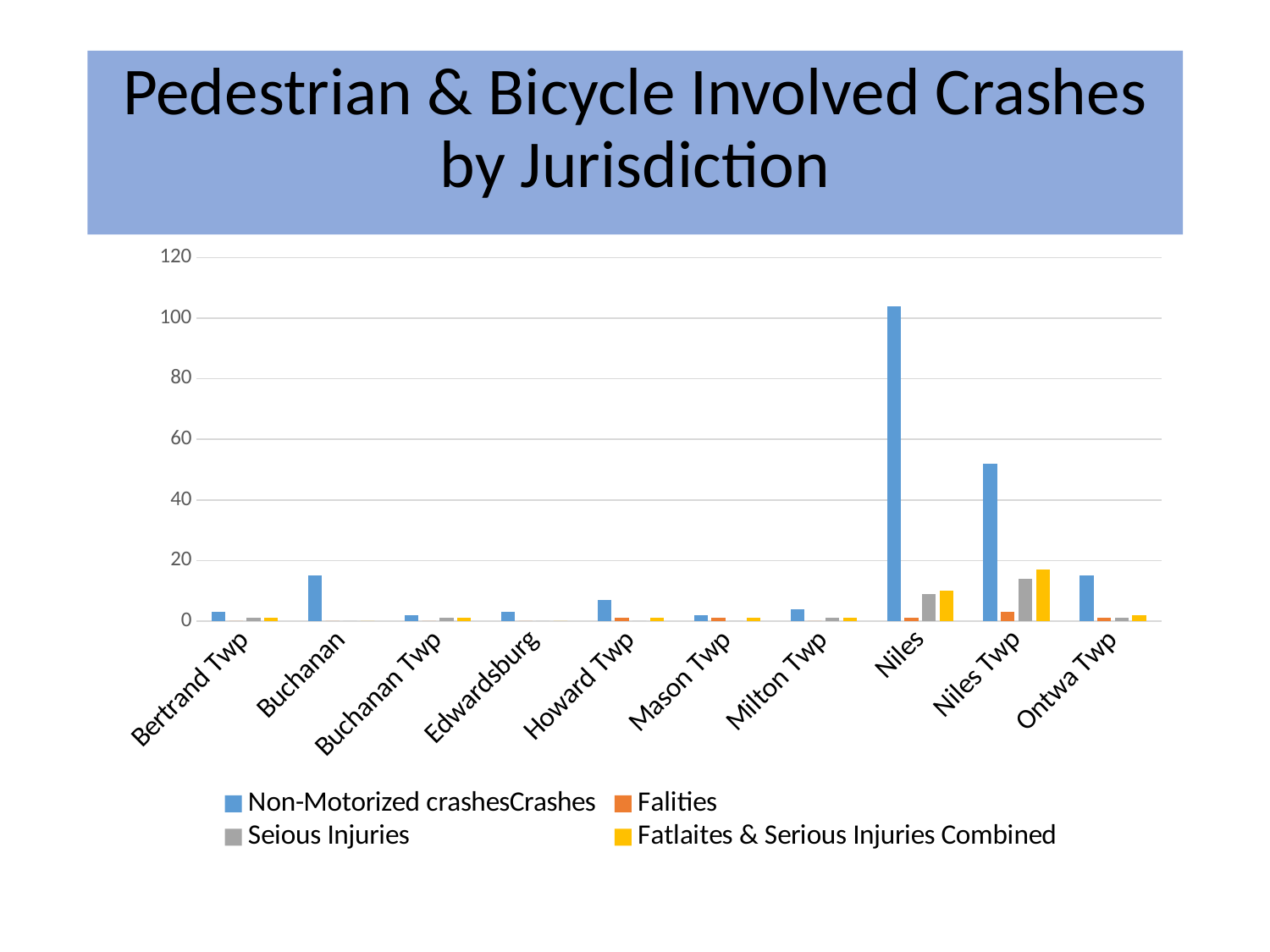
Is the Non-Motorized crashes value for Buchanan greater or less than 20? less Which has more Non-Motorized crashes, Niles or Niles Twp? Niles How many jurisdictions are shown on the x axis? 10 What is the title of the slide? Pedestrian & Bicycle Involved Crashes by Jurisdiction How many series does the legend list? 4 Is the Non-Motorized crashes value for Niles greater or less than 100? greater Which jurisdiction has the highest number of Non-Motorized crashes? Niles Is the Non-Motorized crashes value for Niles Twp greater or less than 60? less Which has more Non-Motorized crashes, Buchanan or Howard Twp? Buchanan Which jurisdiction has the highest value for Fatlaites & Serious Injuries Combined? Niles Twp What kind of chart is shown on the slide? bar chart